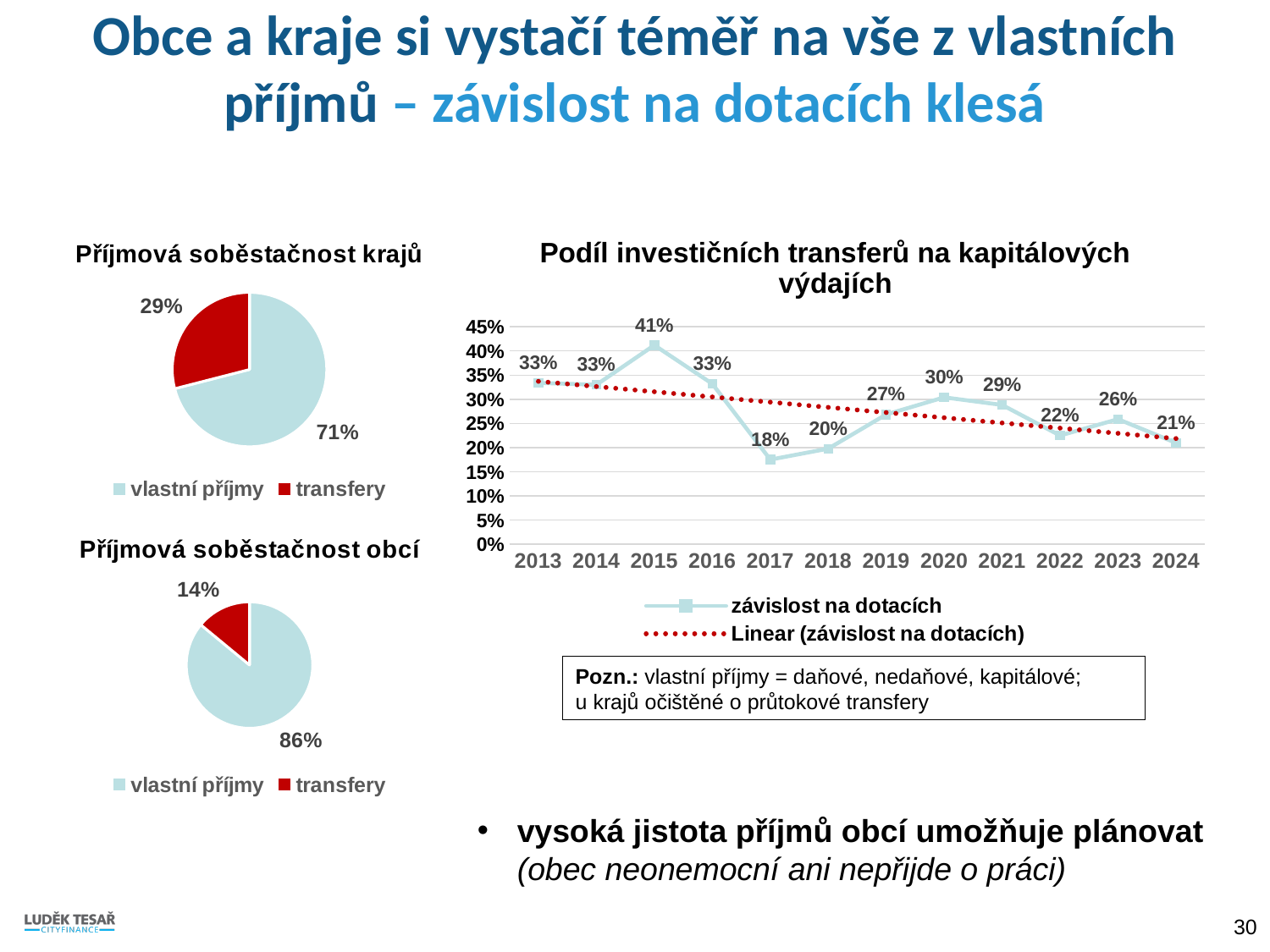
In the chart 'Podíl investičních transferů na kapitálových výdajích', which is larger, the value for 2020 or the value for 2022? 2020 In the pie chart 'Příjmová soběstačnost krajů', what share does 'transfery' have? 29% How many years are plotted in the chart 'Podíl investičních transferů na kapitálových výdajích'? 12 In the chart 'Podíl investičních transferů na kapitálových výdajích', what is the difference between the values for 2015 and 2017? 23% In the pie chart 'Příjmová soběstačnost obcí', what share does 'vlastní příjmy' have? 86% How many entries does the legend of the chart 'Podíl investičních transferů na kapitálových výdajích' list? 2 In the chart 'Podíl investičních transferů na kapitálových výdajích', which year has the highest value? 2015 In the pie chart 'Příjmová soběstačnost obcí', which colour represents 'transfery'? red In the chart 'Podíl investičních transferů na kapitálových výdajích', what is the value for 2024? 21% What kind of chart is 'Podíl investičních transferů na kapitálových výdajích'? line chart In the chart 'Podíl investičních transferů na kapitálových výdajích', which year has the lowest value? 2017 In the chart 'Podíl investičních transferů na kapitálových výdajích', what is the value for 2015? 41%